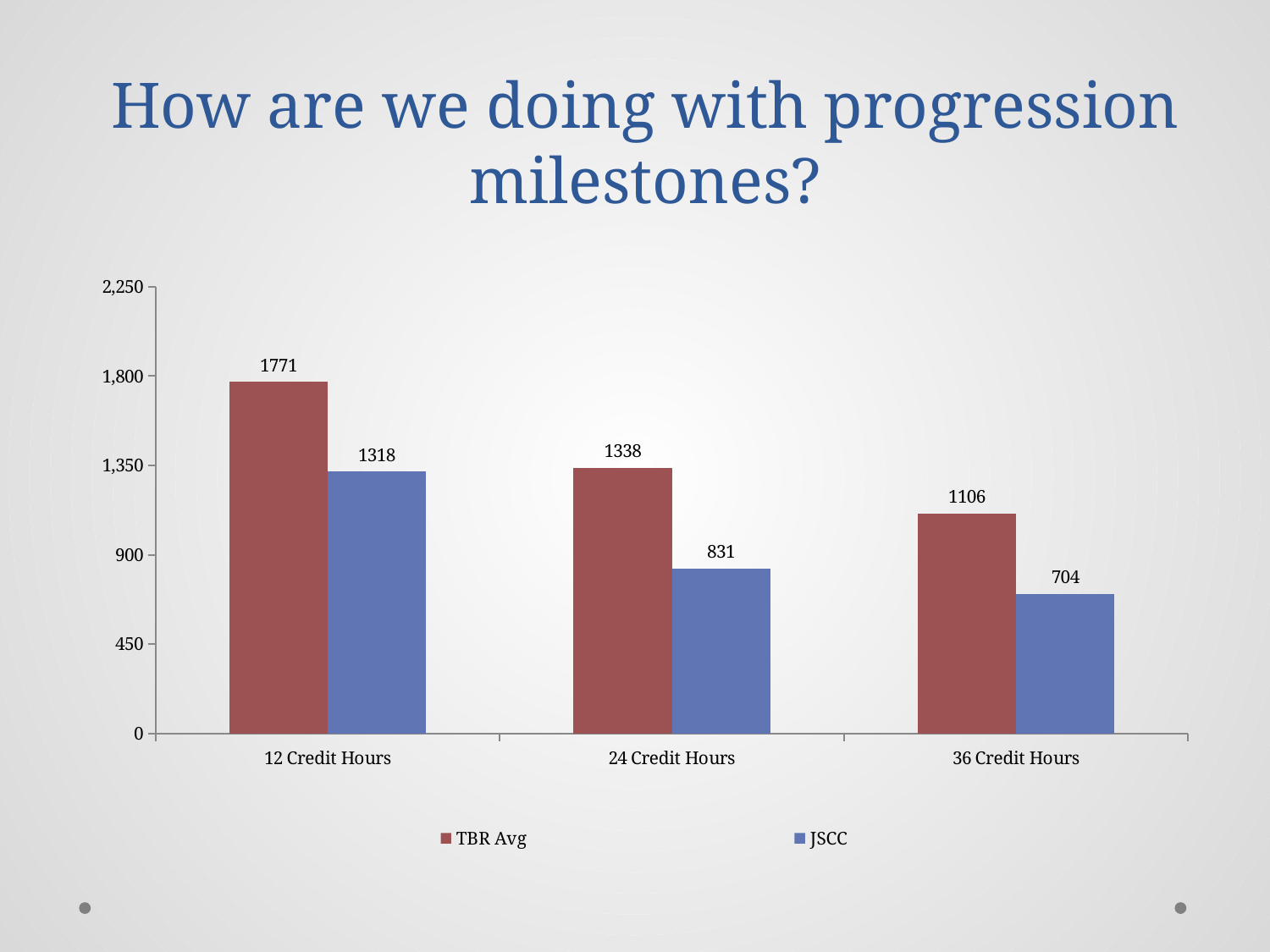
How many series does the legend list? 2 What is the TBR Avg value for 12 Credit Hours? 1771 What is the JSCC value for 36 Credit Hours? 704 Is the JSCC value for 12 Credit Hours greater or less than 1,350? less What kind of chart is shown on the slide? Bar chart Which is larger at 36 Credit Hours, TBR Avg or JSCC? TBR Avg Which credit-hour milestone has the highest TBR Avg value? 12 Credit Hours Which credit-hour milestone has the lowest JSCC value? 36 Credit Hours What is the JSCC value for 24 Credit Hours? 831 What is the difference between the TBR Avg and JSCC values at 24 Credit Hours? 507 How many credit-hour categories are shown on the x axis? 3 Do the JSCC values rise or fall as the credit hours increase along the x axis? Fall